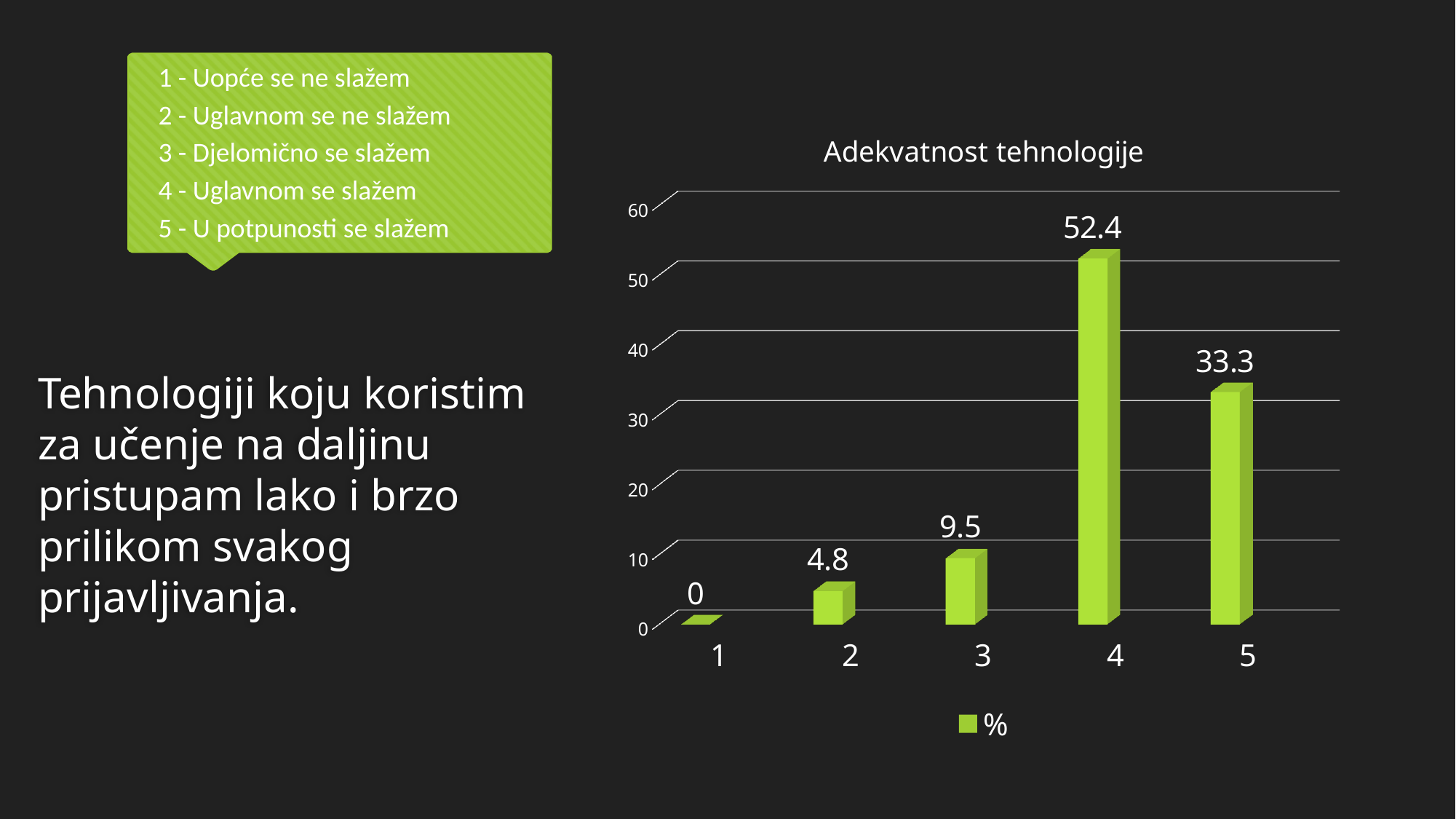
Which category has the lowest value? 1 Is the value for category 5 greater or less than 30? greater How many categories are shown on the x axis? 5 What kind of chart is shown? bar chart What is the value for category 4? 52.4 What is the value for category 2? 4.8 What is the title of the chart? Adekvatnost tehnologije How many series does the legend list? 1 Which category has the highest value? 4 What is the value for category 5? 33.3 What is the difference between the values for categories 4 and 5? 19.1 Which is larger, the value for category 3 or the value for category 2? 3